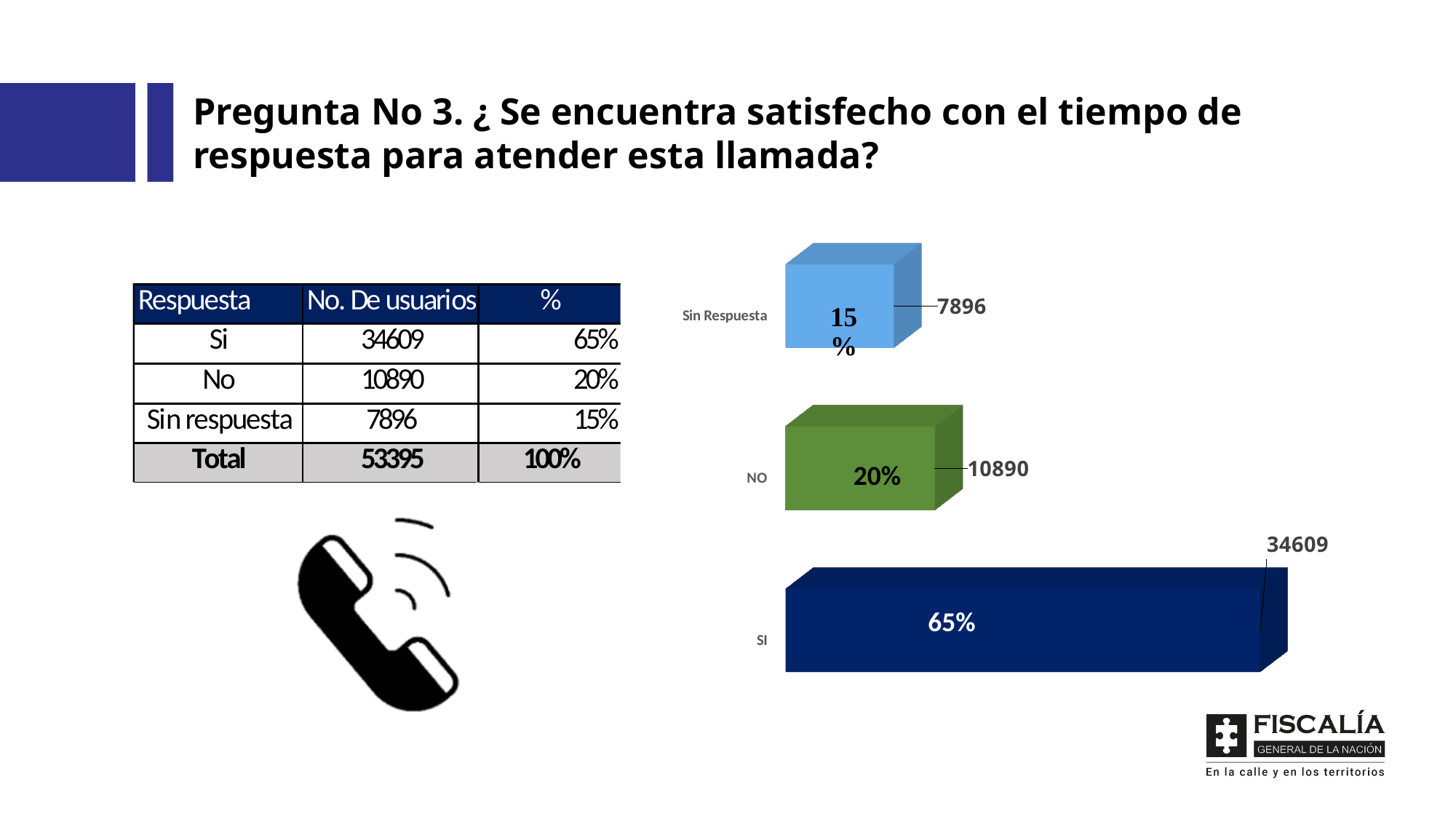
What is the difference between the values for SI and NO in the bar chart? 23719 What percentage is shown on the SI bar in the bar chart? 65% What is the value for NO in the bar chart? 10890 Which category has the highest value in the bar chart? SI What is the value for Sin Respuesta in the bar chart? 7896 What is the difference between the values for NO and Sin Respuesta in the bar chart? 2994 Which category has the lowest value in the bar chart? Sin Respuesta What colour is the NO bar in the bar chart? green What kind of chart is shown on the slide? bar chart How many categories does the bar chart show? 3 Which is larger in the bar chart, the value for NO or the value for Sin Respuesta? NO What is the value for SI in the bar chart? 34609